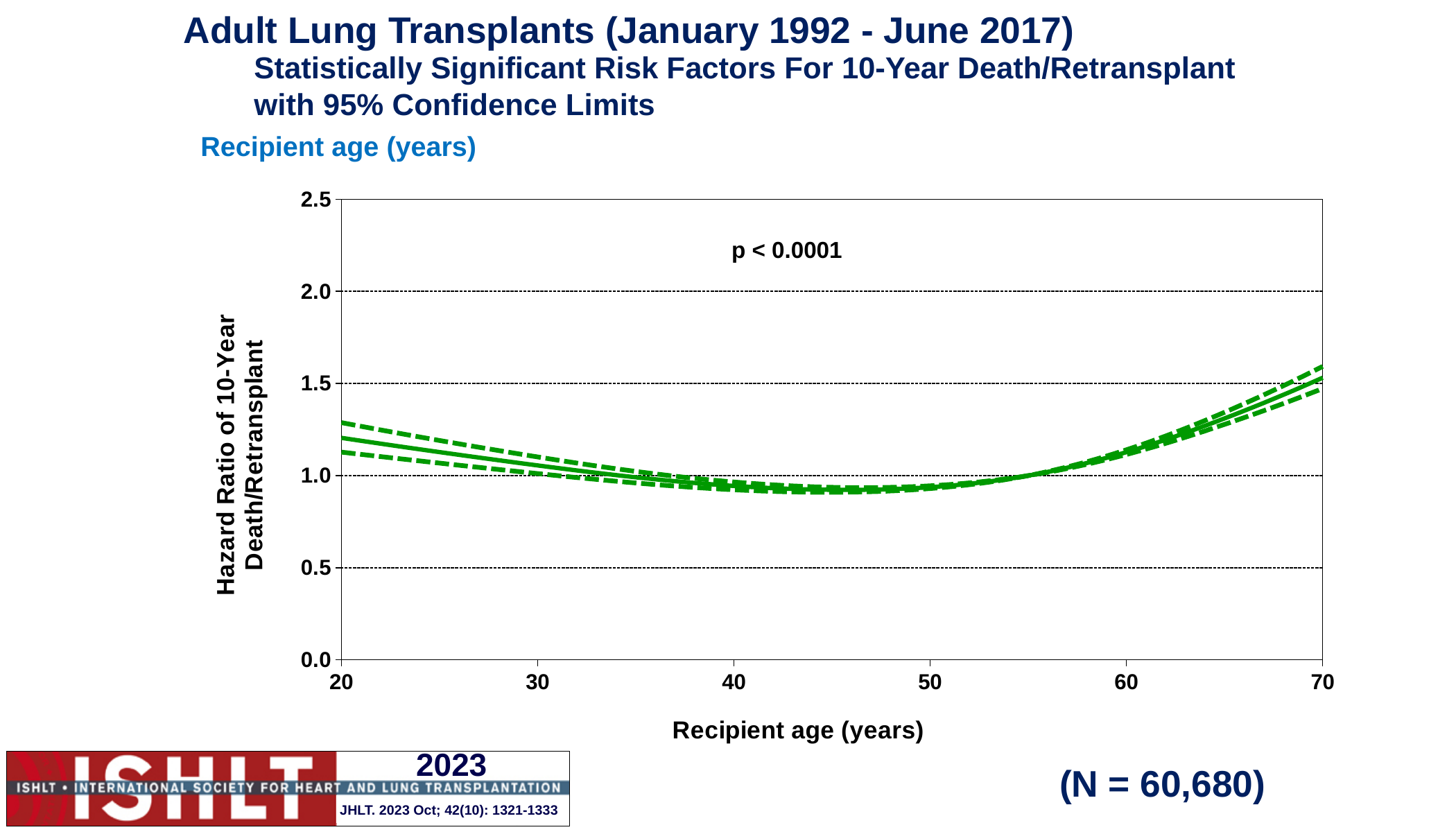
Does the hazard ratio rise or fall as recipient age increases from 20 to 40? falls Is the hazard ratio at a recipient age of 20 greater or less than 1.5? less What kind of chart is shown on the slide? line chart Does the hazard ratio rise or fall as recipient age increases from 50 to 70? rises Which recipient age has the larger hazard ratio, 20 or 70? 70 Is the hazard ratio at a recipient age of 60 greater or less than 1.0? greater What is the label of the x axis of the chart? Recipient age (years) What is the p-value annotation printed on the chart? p < 0.0001 Is the hazard ratio at a recipient age of 45 greater or less than 1.0? less What is the highest value shown on the y axis of the chart? 2.5 Which recipient age has the larger hazard ratio, 20 or 45? 20